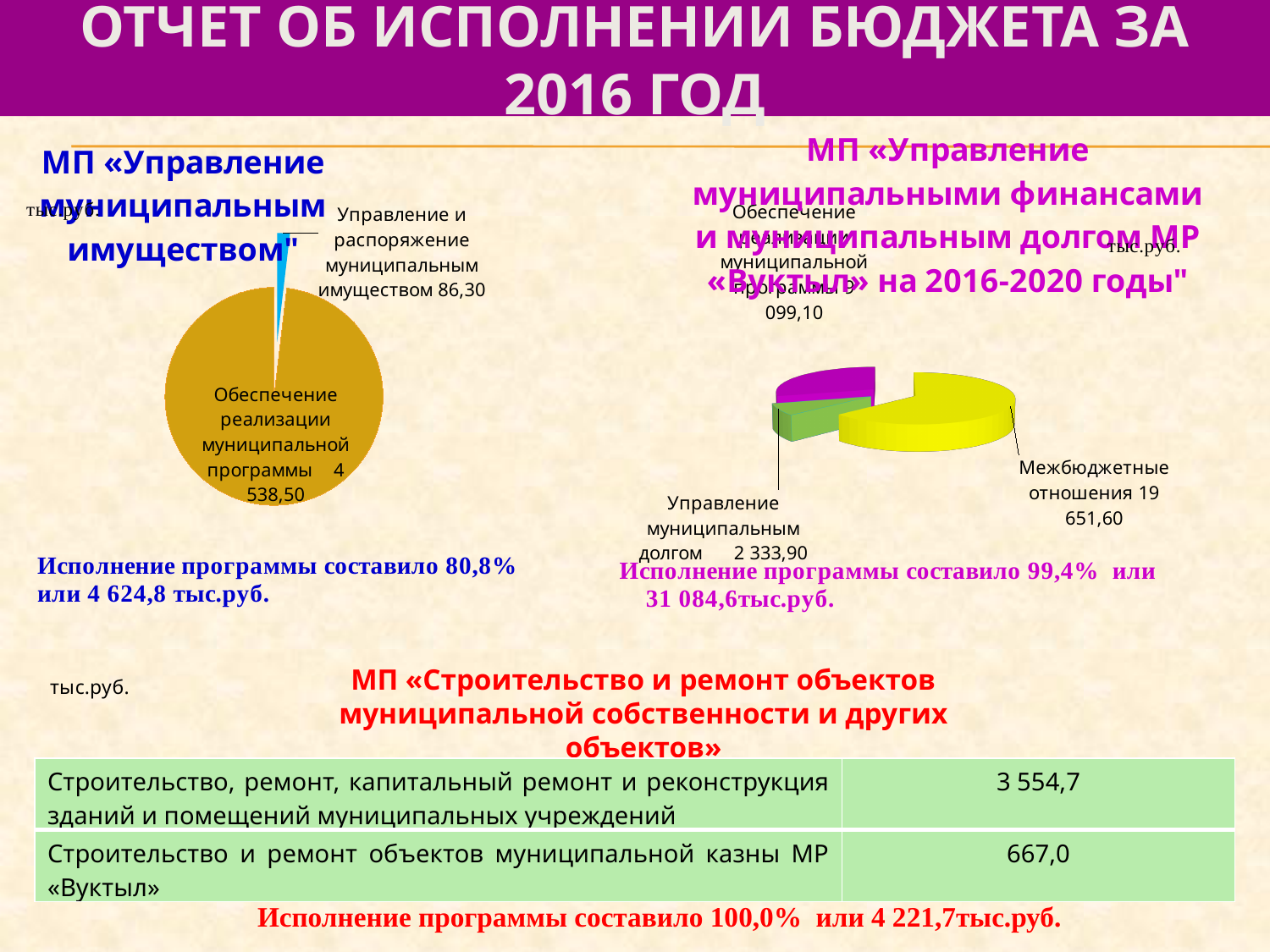
On the left pie chart (МП «Управление муниципальным имуществом»), what is the value for «Обеспечение реализации муниципальной программы»? 4 538,50 On the left pie chart (МП «Управление муниципальным имуществом»), what is the value for «Управление и распоряжение муниципальным имуществом»? 86,30 On the right pie chart (МП «Управление муниципальными финансами и муниципальным долгом»), what is the value for «Межбюджетные отношения»? 19 651,60 What kind of chart is used for МП «Управление муниципальным имуществом» on the left of the slide? Pie chart On the left pie chart (МП «Управление муниципальным имуществом»), what is the difference between «Обеспечение реализации муниципальной программы» and «Управление и распоряжение муниципальным имуществом»? 4 452,20 On the right pie chart (МП «Управление муниципальными финансами и муниципальным долгом»), what is the difference between «Межбюджетные отношения» and «Управление муниципальным долгом»? 17 317,70 How many slices does the left pie chart (МП «Управление муниципальным имуществом») have? 2 On the right pie chart (МП «Управление муниципальными финансами и муниципальным долгом»), what is the value for «Управление муниципальным долгом»? 2 333,90 On the right pie chart (МП «Управление муниципальными финансами и муниципальным долгом»), which is larger: «Межбюджетные отношения» or «Обеспечение реализации муниципальной программы»? Межбюджетные отношения How many slices does the right pie chart (МП «Управление муниципальными финансами и муниципальным долгом») have? 3 On the right pie chart (МП «Управление муниципальными финансами и муниципальным долгом»), which slice is the smallest? Управление муниципальным долгом On the left pie chart (МП «Управление муниципальным имуществом»), which slice is the largest? Обеспечение реализации муниципальной программы